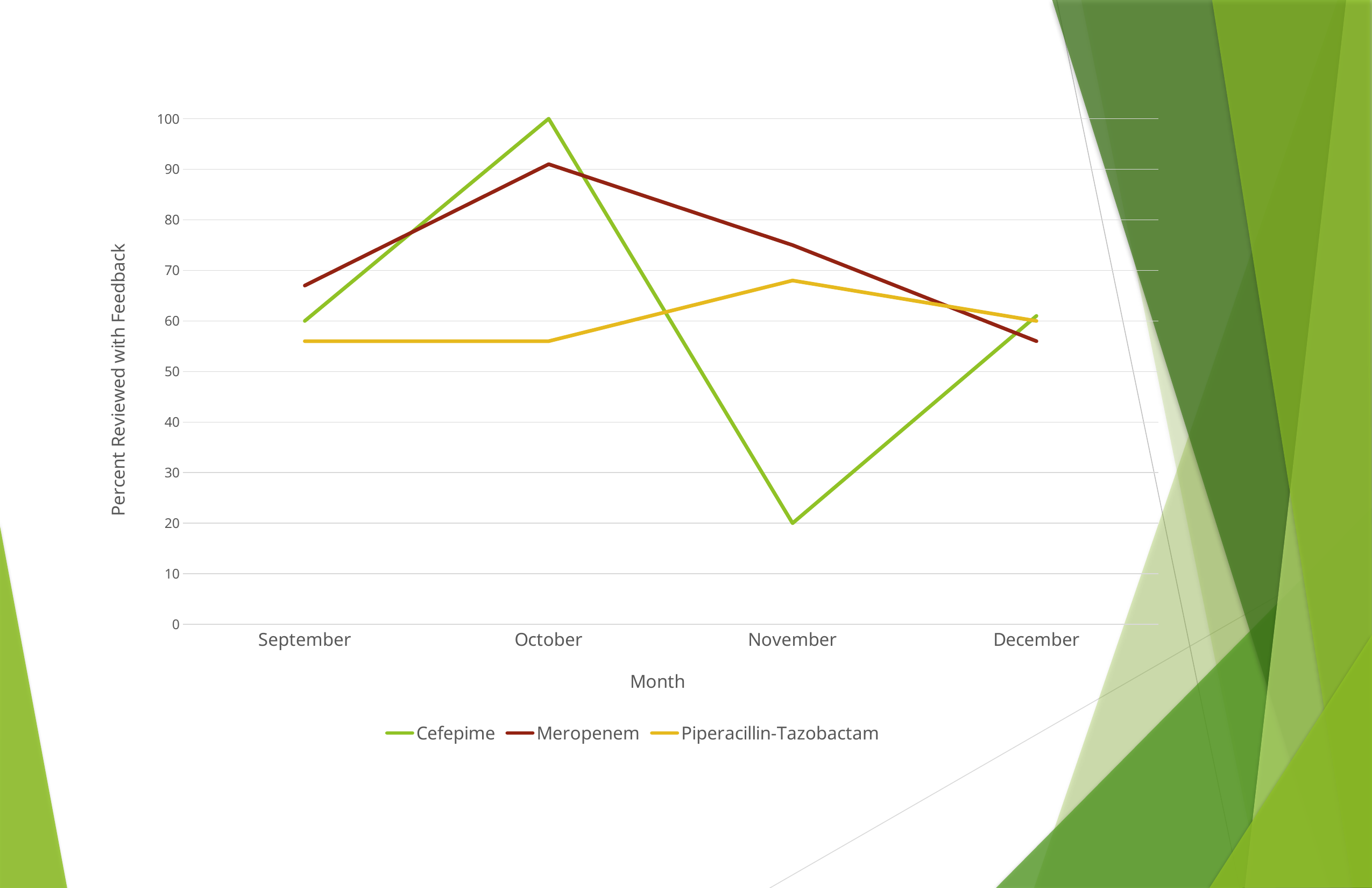
What is the value for Cefepime in October? 100 What is the title of the vertical axis? Percent Reviewed with Feedback How many series does the legend list? 3 What is the value for Cefepime in September? 60 In which month is the Cefepime value highest? October How many months are shown on the x axis? 4 What kind of chart is shown on the slide? line chart In which month is the Cefepime value lowest? November Does the Cefepime line rise or fall from October to November? fall What is the value for Cefepime in November? 20 In November, which is larger: the value for Cefepime or the value for Meropenem? Meropenem Is the value for Meropenem in November greater or less than 80? less